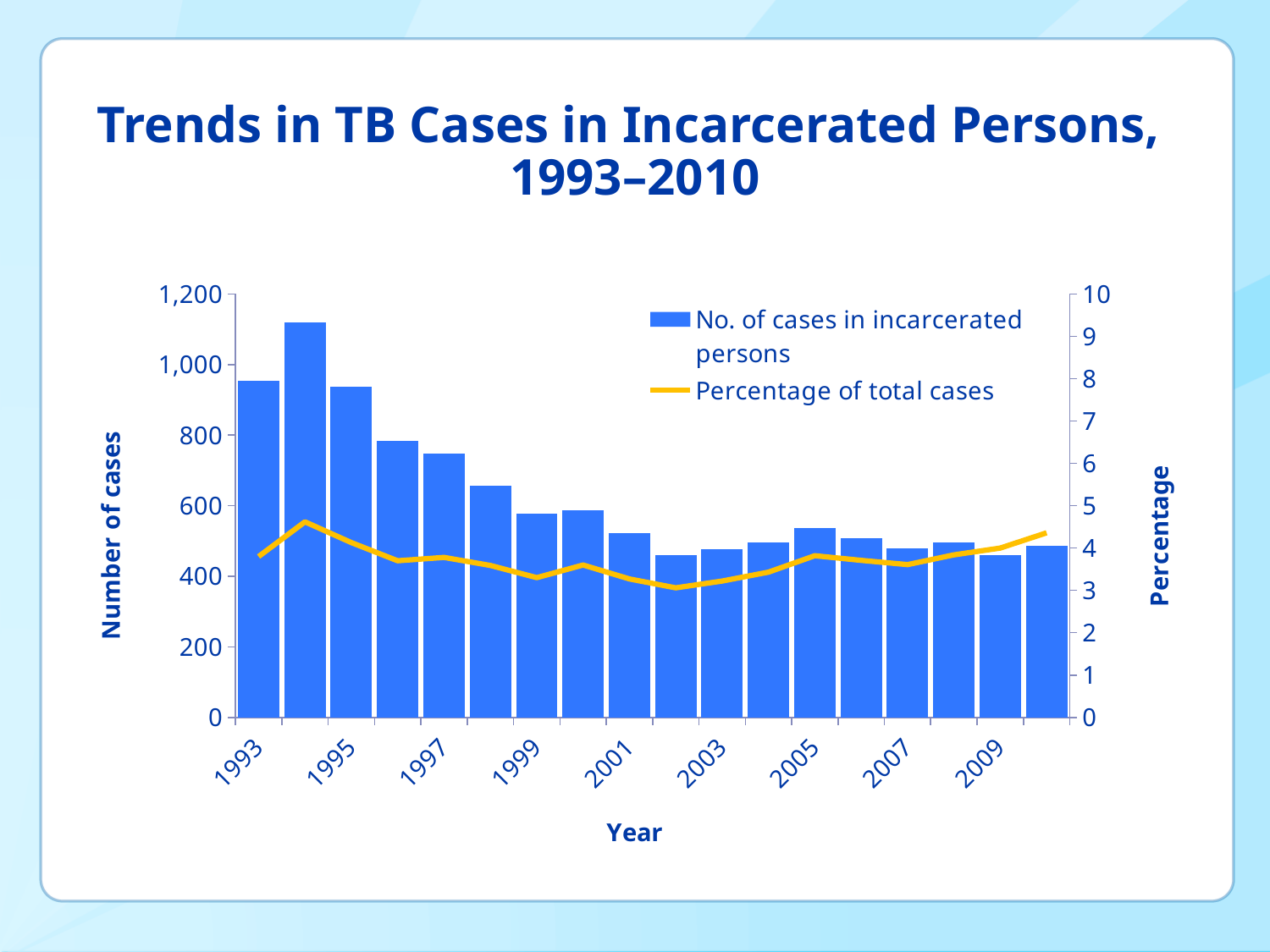
Is the percentage of total cases for 2002 greater or less than 4? less Is the number of cases in incarcerated persons for 1994 greater or less than 1,000? greater Do the number of cases in incarcerated persons rise or fall from 1994 to 2002? fall Which year has more cases in incarcerated persons, 1997 or 1999? 1997 Is the number of cases in incarcerated persons for 1993 greater or less than 800? greater Which year has the highest number of cases in incarcerated persons? 1994 How many series does the legend list? 2 What kind of chart is used to show the number of cases in incarcerated persons? bar chart What is the label of the right-hand vertical axis? Percentage What is the title of the chart? Trends in TB Cases in Incarcerated Persons, 1993–2010 How many years (bars) are plotted in the chart? 18